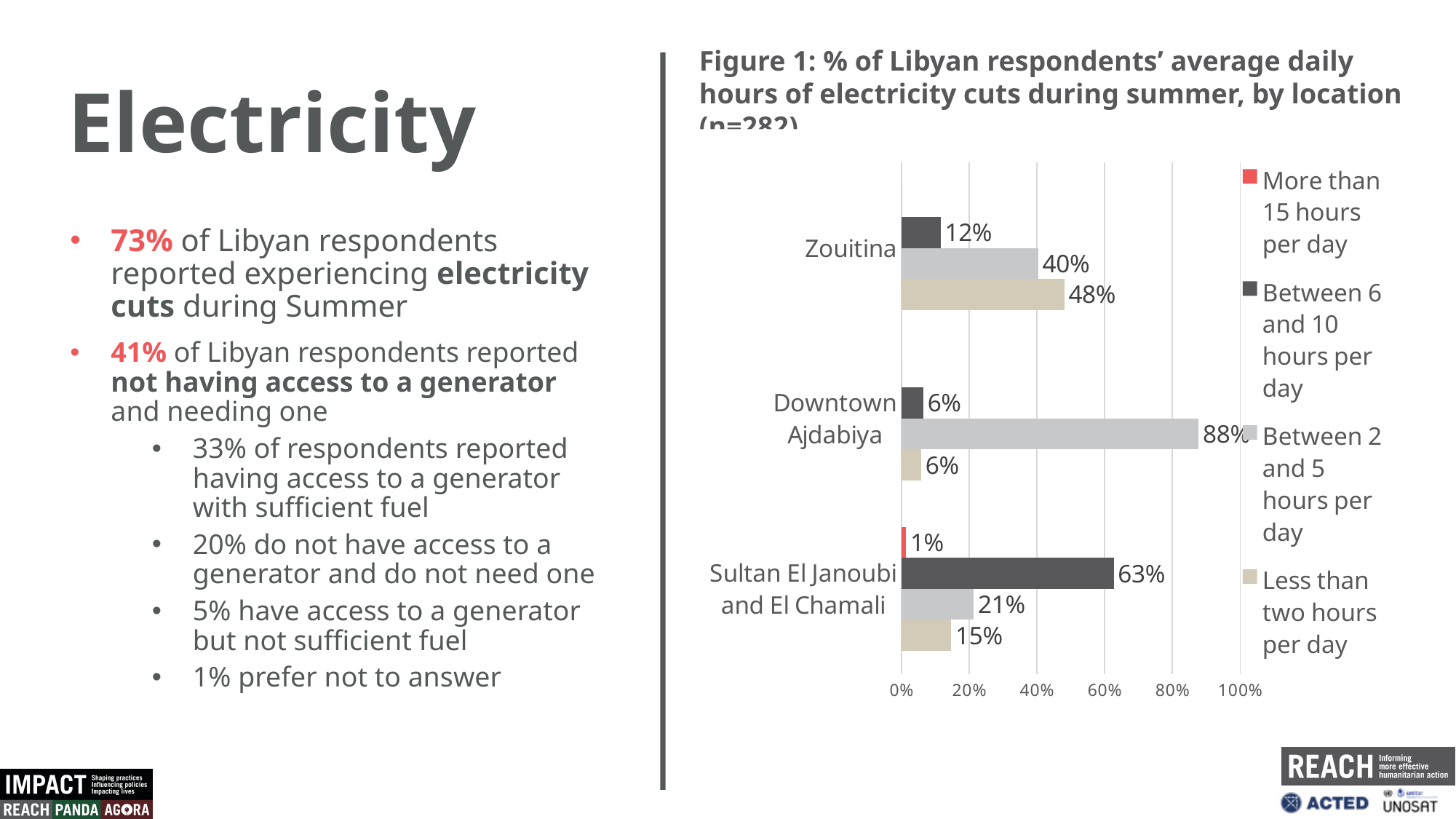
How many series does the legend of Figure 1 list? 4 In Figure 1, which location has the highest share of respondents reporting between 2 and 5 hours of cuts per day? Downtown Ajdabiya In Figure 1, what percentage of respondents in Downtown Ajdabiya reported between 2 and 5 hours of cuts per day? 88% In Figure 1, what percentage of respondents in Sultan El Janoubi and El Chamali reported between 6 and 10 hours of cuts per day? 63% How many locations are shown on the y axis of Figure 1? 3 In Figure 1, which is larger: the share of Zouitina respondents reporting between 6 and 10 hours of cuts, or the share of Sultan El Janoubi and El Chamali respondents reporting between 6 and 10 hours? Sultan El Janoubi and El Chamali In Figure 1, what percentage of respondents in Sultan El Janoubi and El Chamali reported more than 15 hours of cuts per day? 1% In Figure 1, what is the difference between the share of Zouitina respondents reporting less than two hours of cuts and those reporting between 2 and 5 hours? 8% In Figure 1, which legend entry is shown in red? More than 15 hours per day What type of chart is shown in Figure 1? bar chart In Figure 1, what percentage of respondents in Zouitina reported less than two hours of electricity cuts per day? 48% In Figure 1, which location has the lowest share of respondents reporting less than two hours of cuts per day? Downtown Ajdabiya